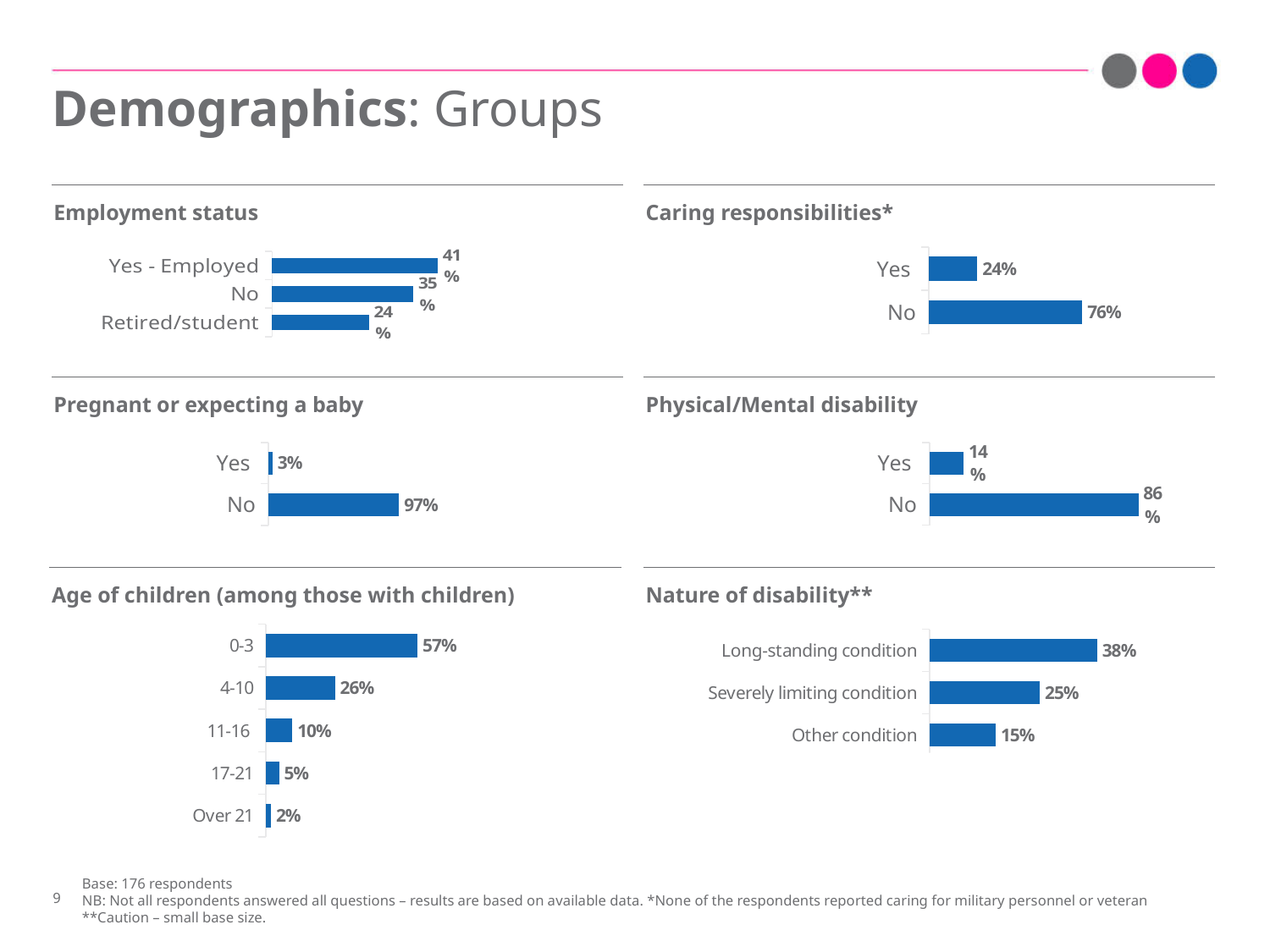
In the Pregnant or expecting a baby chart, what is the value for Yes? 3% In the Age of children (among those with children) chart, which category has the highest value? 0-3 In the Physical/Mental disability chart, which is larger, Yes or No? No In the Caring responsibilities* chart, what is the difference between No and Yes? 52% What type of chart is the Nature of disability** chart? Bar chart In the Employment status chart, what is the value for Yes - Employed? 41% In the Age of children (among those with children) chart, how many categories are shown? 5 In the Nature of disability** chart, what is the difference between Long-standing condition and Other condition? 23% In the Nature of disability** chart, what is the value for Severely limiting condition? 25% In the Age of children (among those with children) chart, what is the value for 4-10? 26% In the Caring responsibilities* chart, what is the value for No? 76% In the Employment status chart, which category has the lowest value? Retired/student